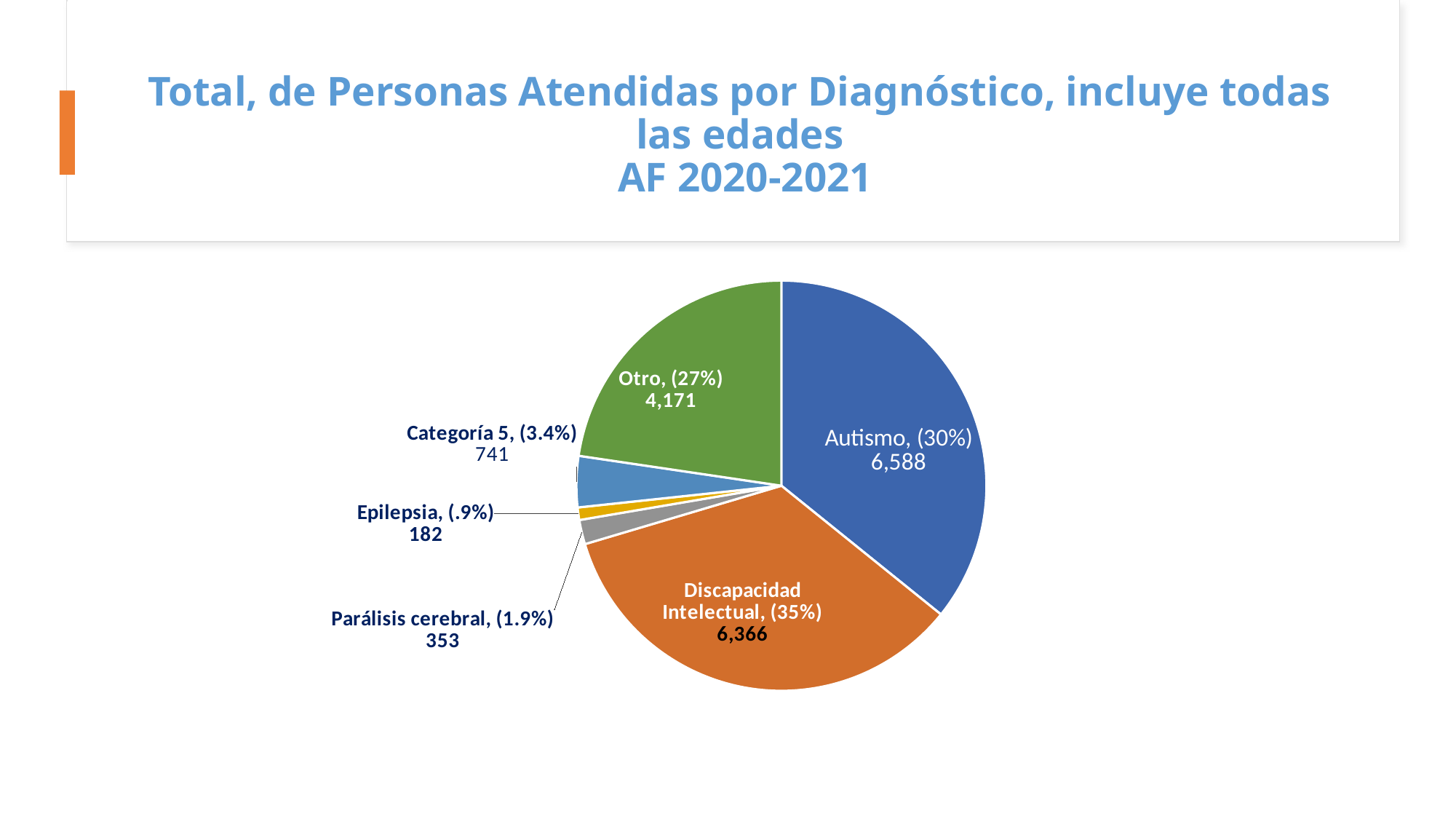
What is the difference between the values for Otro and Categoría 5? 3,430 What is the value shown for Discapacidad Intelectual? 6,366 What is the value shown for Autismo? 6,588 What kind of chart is shown on the slide? pie chart What is the value shown for Parálisis cerebral? 353 What fiscal year does the chart title refer to? AF 2020-2021 What percentage share of the pie does Otro represent? 27% Which is larger, the value for Categoría 5 or the value for Parálisis cerebral? Categoría 5 What is the value shown for Otro? 4,171 Which category has the smallest slice in the pie chart? Epilepsia How many slices does the pie chart have? 6 What percentage share of the pie does Categoría 5 represent? 3.4%